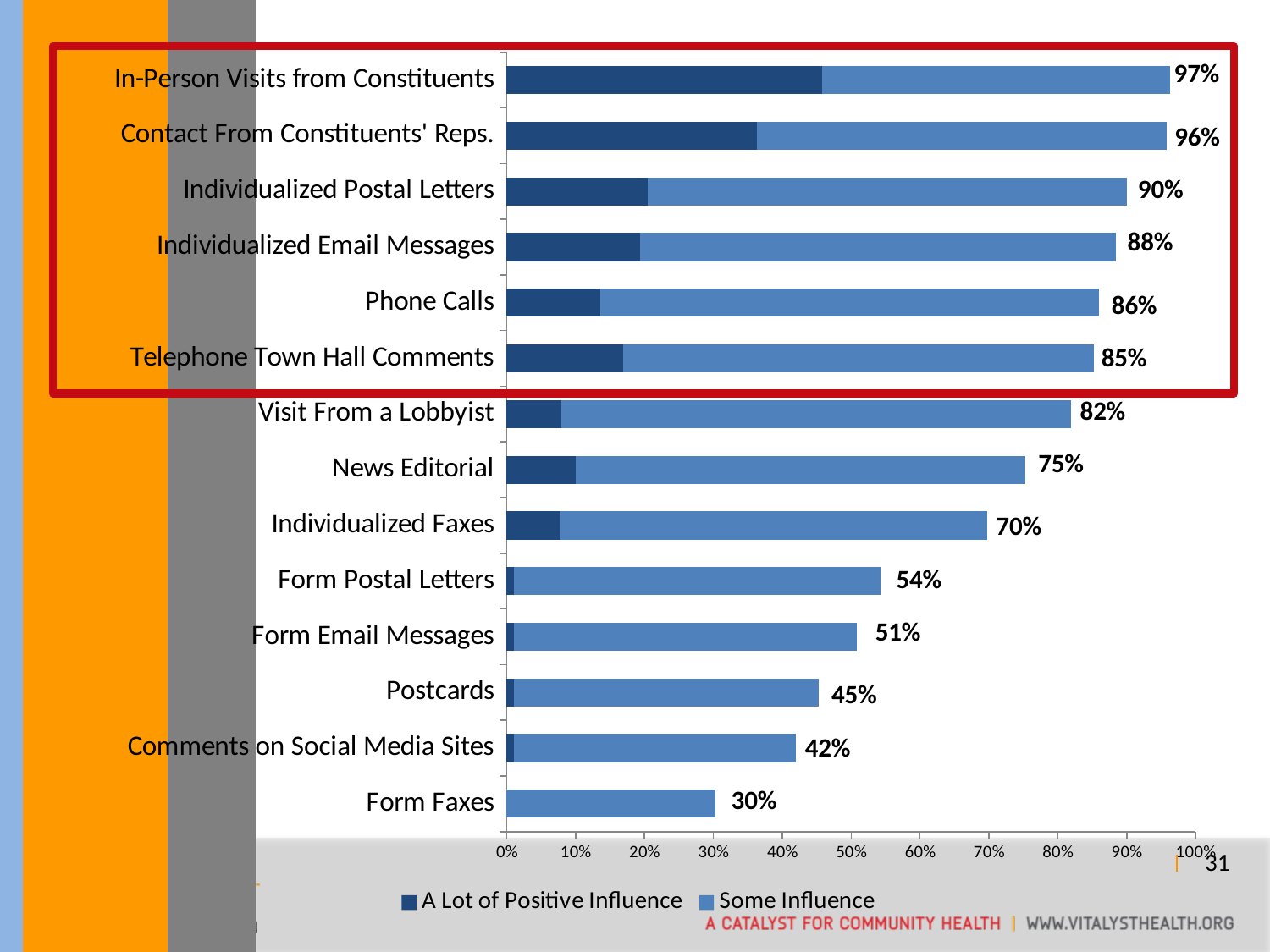
Is the 'A Lot of Positive Influence' value for Phone Calls greater or less than 20%? less What is the total value shown for Visit From a Lobbyist? 82% Which category has the highest total value? In-Person Visits from Constituents What kind of chart is shown on the slide? Stacked bar chart Which has a larger total value, News Editorial or Individualized Faxes? News Editorial What is the difference between the total values for Individualized Postal Letters and Form Postal Letters? 36% How many series does the legend list? 2 What is the total value shown for Form Faxes? 30% How many categories are shown on the chart? 14 Is the 'A Lot of Positive Influence' value for In-Person Visits from Constituents greater or less than 40%? greater What is the total value shown for In-Person Visits from Constituents? 97% Which category has the lowest total value? Form Faxes